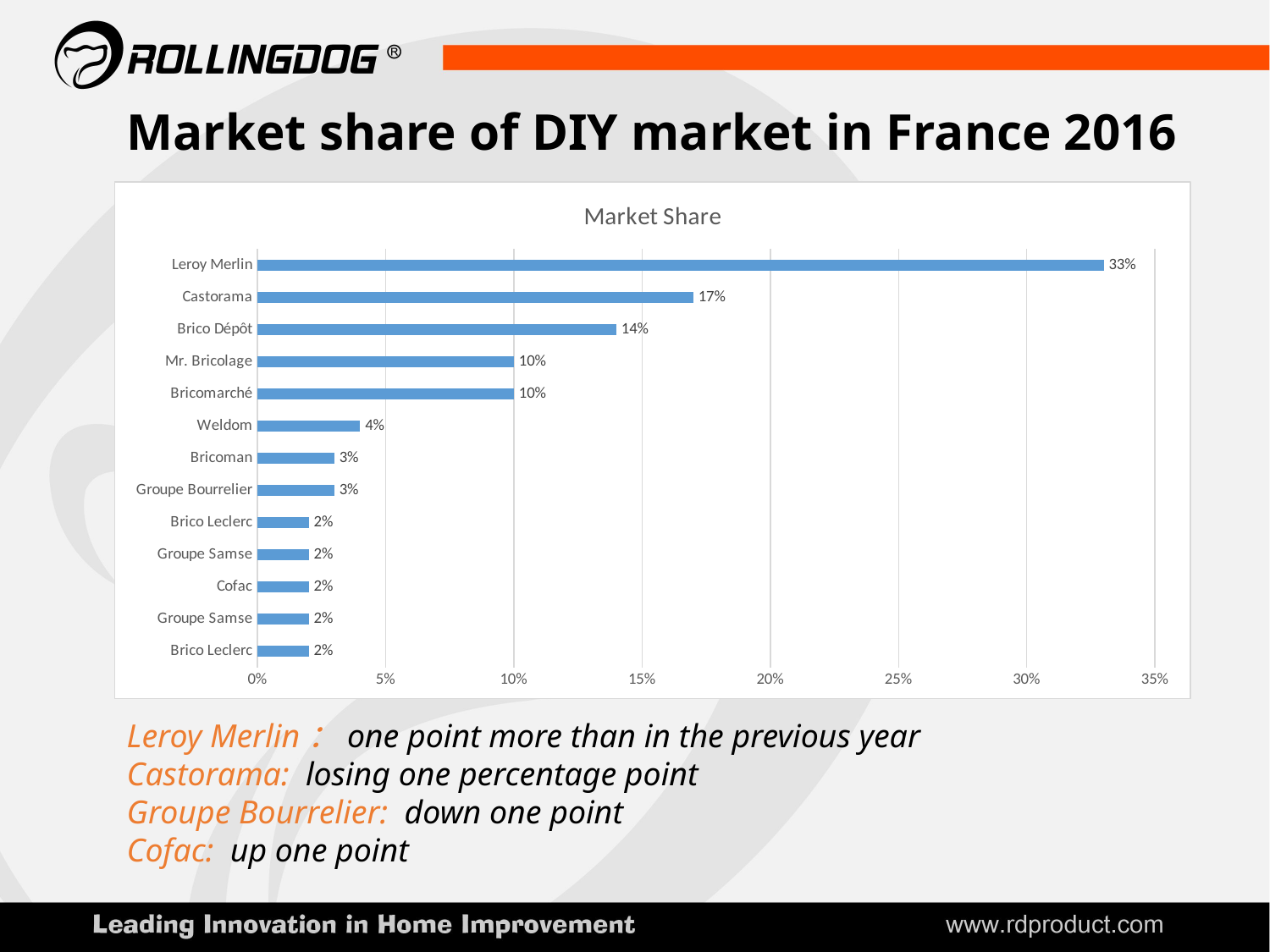
What is the market share shown for Leroy Merlin? 33% What type of chart is shown on the slide? Bar chart How many bars are plotted in the chart? 13 Which company has the highest market share in the chart? Leroy Merlin What is the market share shown for Weldom? 4% What is the difference in market share between Leroy Merlin and Castorama? 16% What is the market share shown for Brico Dépôt? 14% What is the difference in market share between Brico Dépôt and Mr. Bricolage? 4% Which has a larger market share, Weldom or Bricoman? Weldom What is the market share shown for Cofac? 2% What is the market share shown for Castorama? 17% Which has a larger market share, Castorama or Brico Dépôt? Castorama